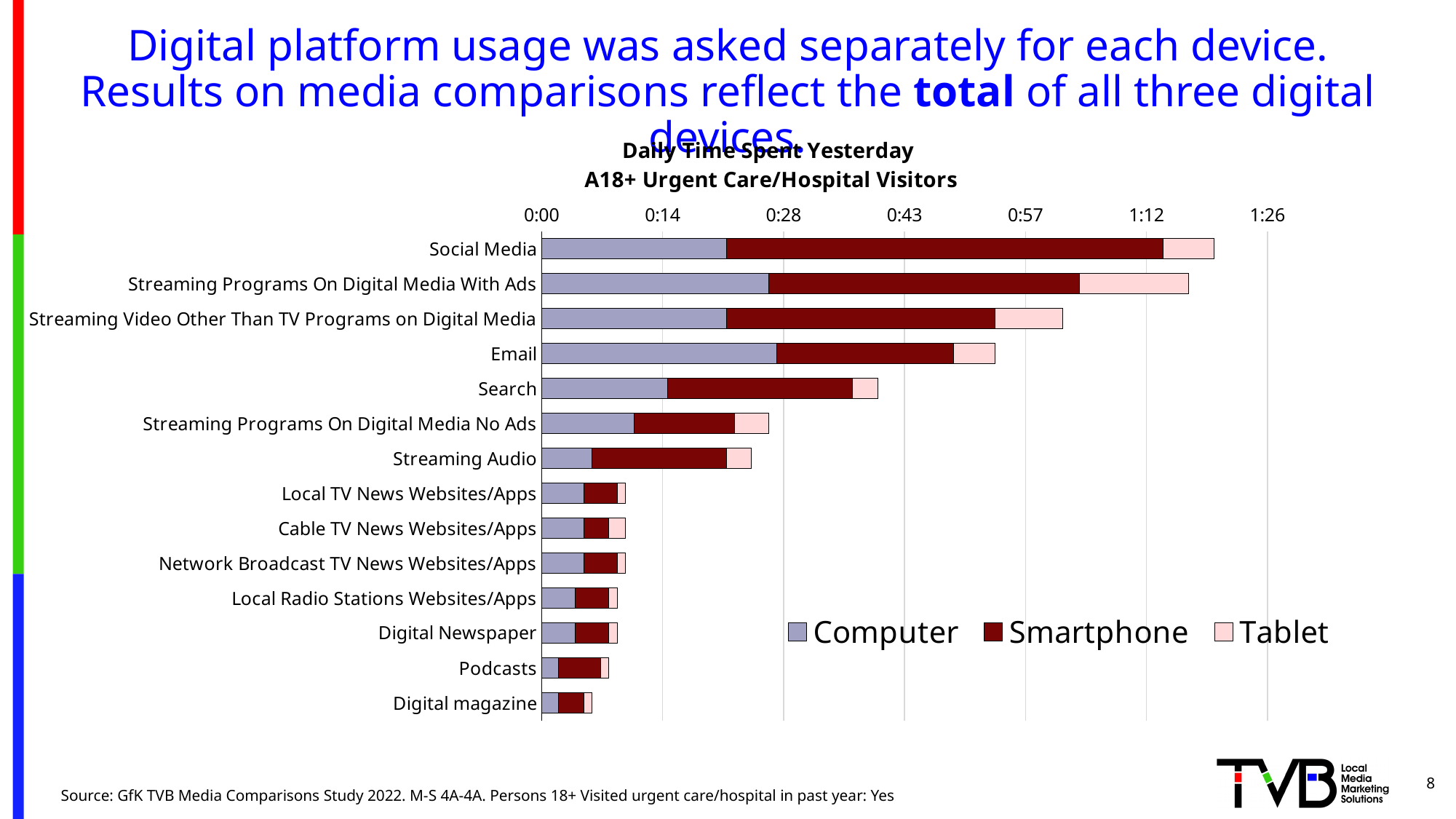
Is the total daily time spent for Social Media greater or less than 1:12? greater What kind of chart is shown on the slide? Stacked bar chart Do the total bar lengths increase or decrease going down the list of platforms from Social Media to Digital magazine? decrease Which digital platform has the longest total bar? Social Media Is the total daily time spent for Search greater or less than 0:57? less Is the total daily time spent for Streaming Audio greater or less than 0:28? less Which has a larger total daily time spent, Email or Search? Email Which digital platform has the shortest total bar? Digital magazine How many categories (digital platforms) are plotted in the chart? 14 Which series is shown in the dark red colour in the legend? Smartphone How many series does the legend list? 3